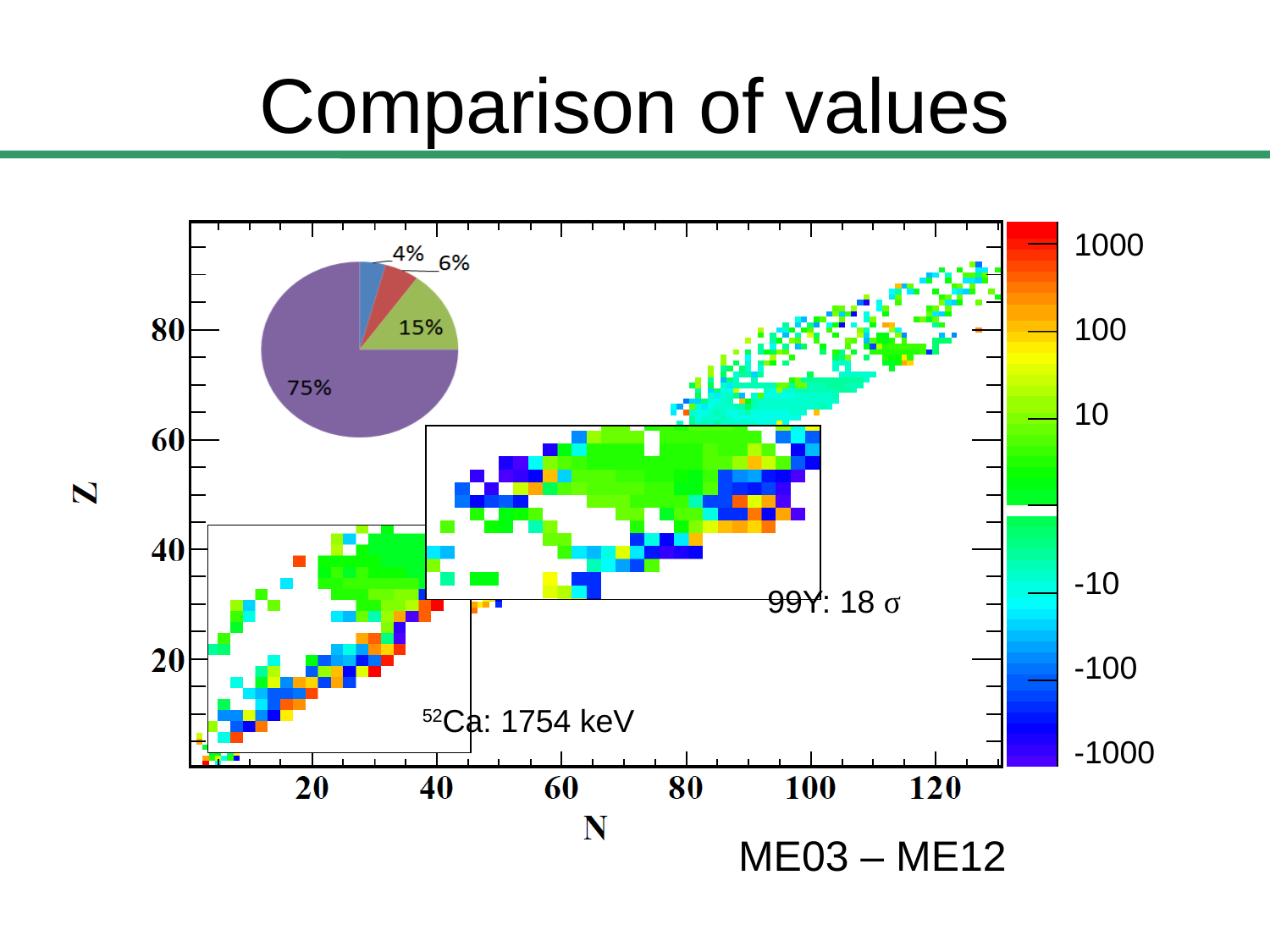
What is the lowest value shown on the colour scale of the main chart? -1000 What value is annotated for 52Ca on the main chart? 1754 keV How many slices does the inset pie chart have? 4 In the inset pie chart, which slice is larger: the red slice or the blue slice? the red slice (6%) In the inset pie chart, what is the share of the smallest slice? 4% In the inset pie chart, is the purple slice's share greater or less than 50%? greater What are the labels of the horizontal and vertical axes of the main chart? N and Z In the inset pie chart, what is the difference between the largest slice and the second-largest slice? 60% In the inset pie chart, what is the share of the largest slice? 75% In the inset pie chart, what is the share of the green slice? 15% What kind of chart is the inset chart in the upper left of the plot area? pie chart What is the highest value shown on the colour scale of the main chart? 1000